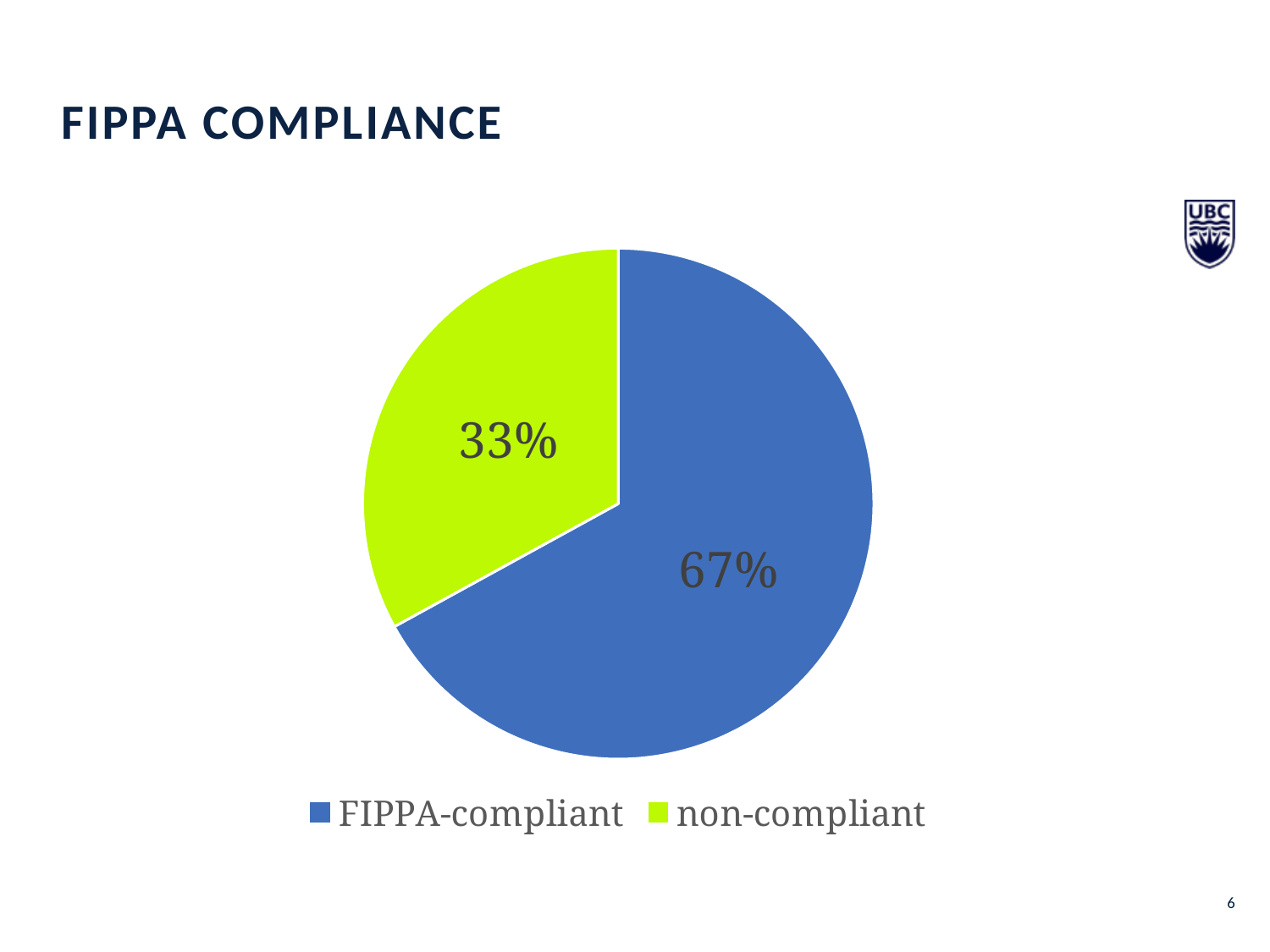
Which is larger, the FIPPA-compliant slice or the non-compliant slice? FIPPA-compliant What colour is the non-compliant slice? green What share of the pie is non-compliant? 33% What is the difference in percentage points between the FIPPA-compliant and non-compliant slices? 34 Which slice is the smallest? non-compliant What is the title of the slide? FIPPA COMPLIANCE What share of the pie is FIPPA-compliant? 67% Which slice is the largest? FIPPA-compliant How many slices does the pie chart have? 2 How many entries does the legend list? 2 What kind of chart is shown on the slide? pie chart